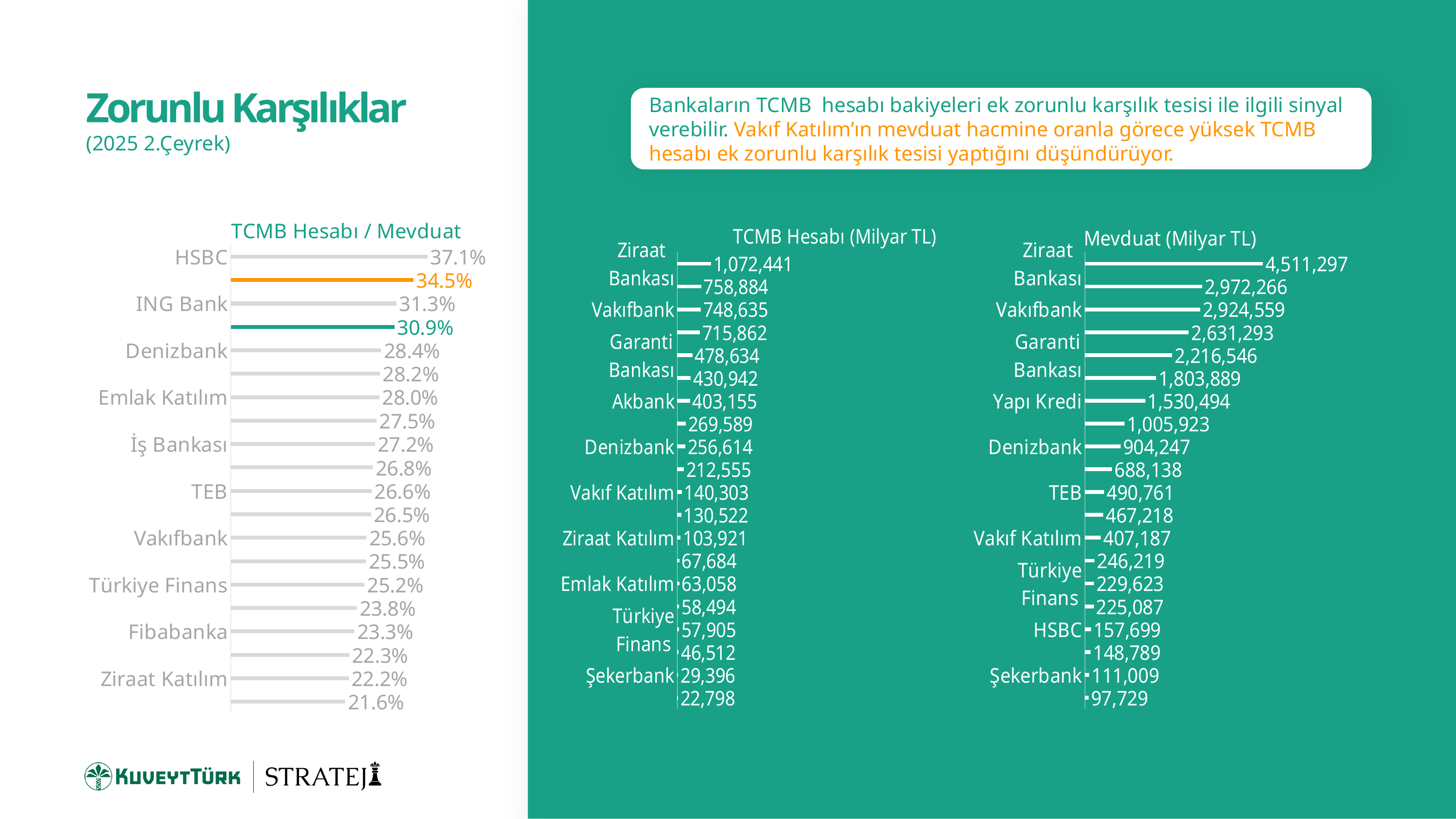
In the 'TCMB Hesabı / Mevduat' chart, which labelled bank has the highest value? HSBC In the 'Mevduat (Milyar TL)' chart, what is the value for Yapı Kredi? 1,530,494 In the 'TCMB Hesabı (Milyar TL)' chart, what is the value for Ziraat Bankası? 1,072,441 In the 'TCMB Hesabı / Mevduat' chart, what is the difference between HSBC and ING Bank? 5.8% In the 'TCMB Hesabı / Mevduat' chart, what is the value for Denizbank? 28.4% In the 'TCMB Hesabı / Mevduat' chart, what is the value for HSBC? 37.1% How many bars are plotted in the 'Mevduat (Milyar TL)' chart? 20 What type of chart is the 'TCMB Hesabı / Mevduat' chart? Bar chart In the 'TCMB Hesabı (Milyar TL)' chart, what is the value for Şekerbank? 29,396 In the 'TCMB Hesabı (Milyar TL)' chart, what is the value for Vakıf Katılım? 140,303 In the 'TCMB Hesabı / Mevduat' chart, which is larger, the value for TEB or the value for Vakıfbank? TEB In the 'Mevduat (Milyar TL)' chart, what is the value for Ziraat Bankası? 4,511,297